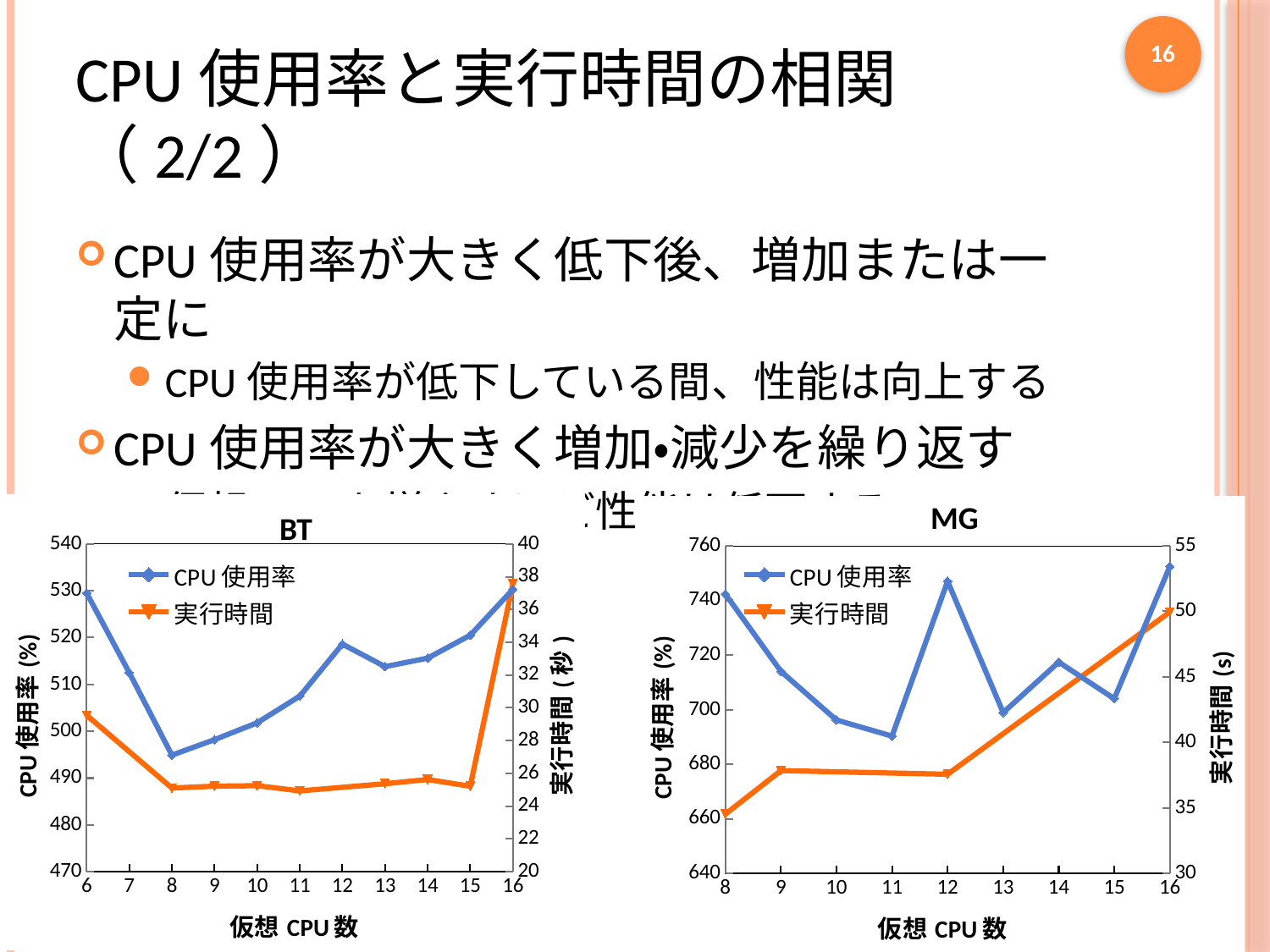
In the MG chart, is the CPU 使用率 value at 仮想 CPU 数 11 greater or less than 700? less In the BT chart, at which 仮想 CPU 数 is CPU 使用率 lowest? 8 What kind of chart is the BT chart? line chart In the MG chart, does 実行時間 generally rise or fall as 仮想 CPU 数 increases from 8 to 16? rise In the BT chart, at which 仮想 CPU 数 is 実行時間 highest? 16 In the MG chart, at which 仮想 CPU 数 is 実行時間 lowest? 8 In the BT chart, which is larger: CPU 使用率 at 仮想 CPU 数 6 or at 仮想 CPU 数 8? 6 In the MG chart, is the 実行時間 value at 仮想 CPU 数 16 greater or less than 45? greater In the MG chart, how many 仮想 CPU 数 values are plotted along the x axis? 9 In the BT chart, how many 仮想 CPU 数 values are plotted along the x axis? 11 How many series does the legend of the MG chart list? 2 In the BT chart, is the CPU 使用率 value at 仮想 CPU 数 8 greater or less than 500? less